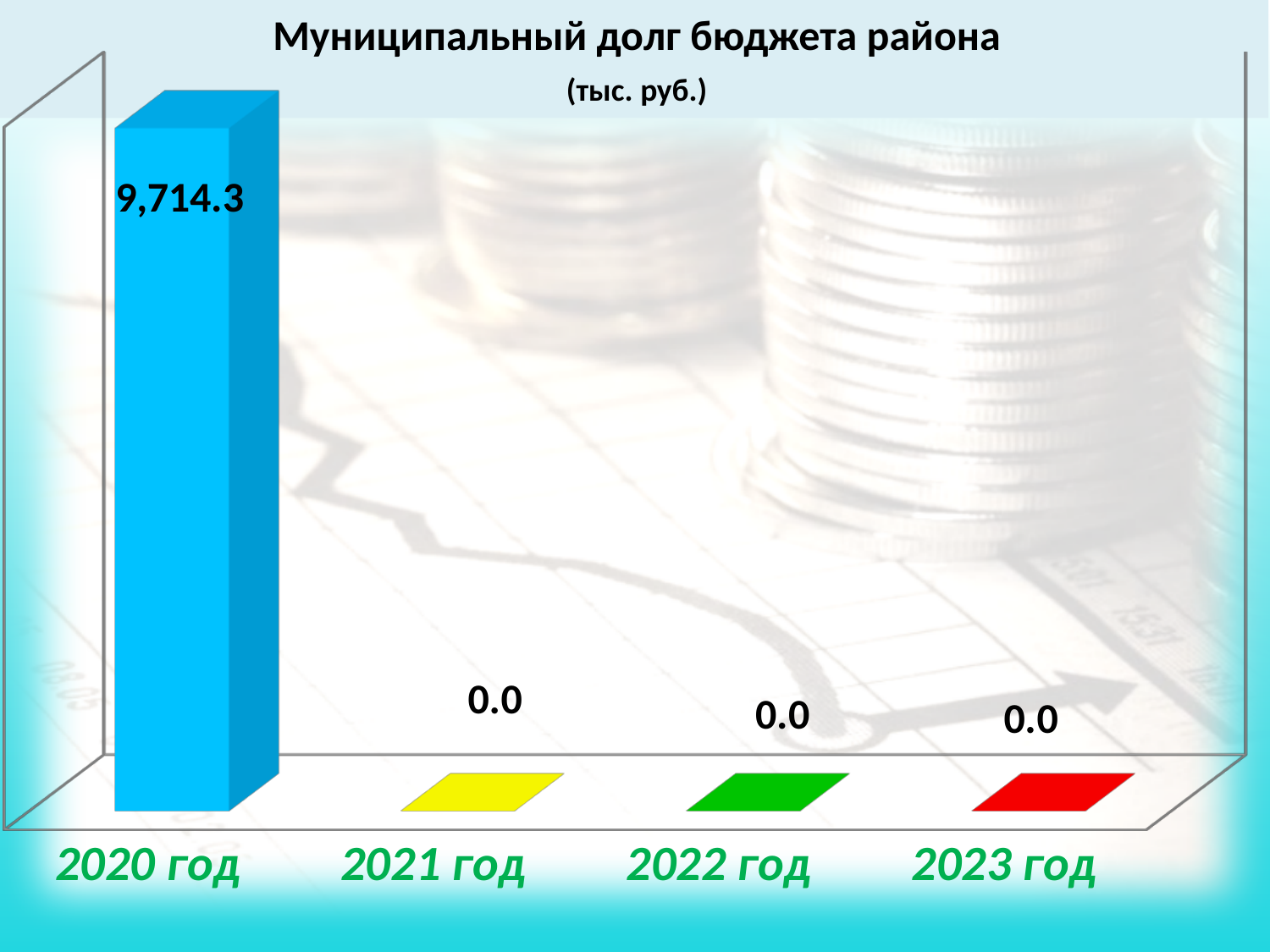
What is the title of the chart? Муниципальный долг бюджета района Which year has the highest value? 2020 год How many years have a value of 0.0? 3 How many years are shown on the chart? 4 What kind of chart is shown on the slide? bar chart What is the value for 2020 год? 9,714.3 What is the value for 2023 год? 0.0 What is the difference between the values for 2020 год and 2022 год? 9,714.3 Do the values rise or fall from 2020 год to 2021 год? fall Which is larger, the value for 2020 год or the value for 2021 год? 2020 год What is the value for 2021 год? 0.0 What unit is given under the chart title? тыс. руб.